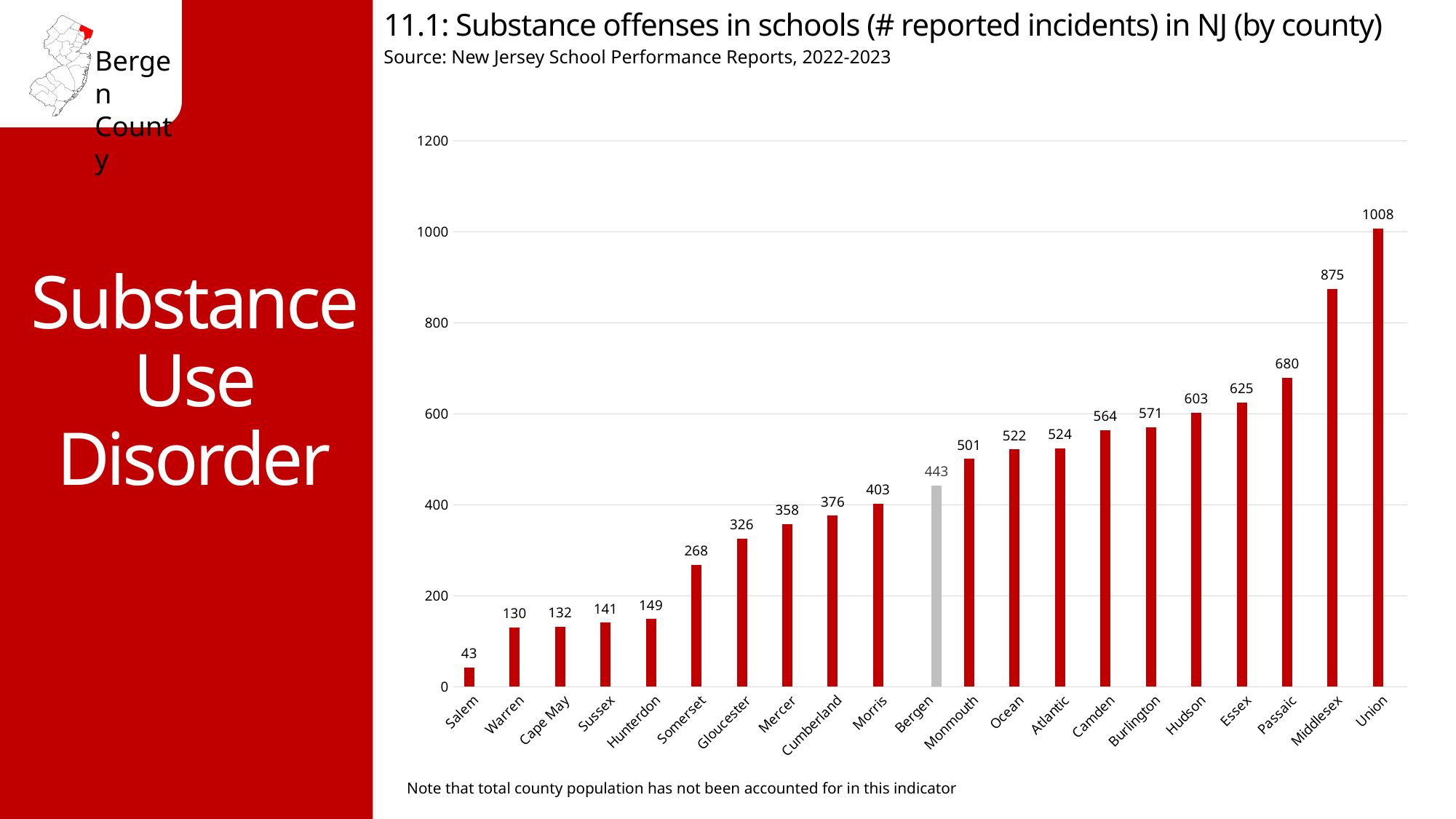
What kind of chart is shown on the slide? bar chart How many counties are shown on the chart? 21 Which bar is coloured grey instead of red? Bergen Which has more reported incidents, Camden or Morris? Camden What is the value shown for Middlesex? 875 What is the difference between the values for Bergen and Monmouth? 58 Do the values rise or fall moving from left to right along the x axis? rise What is the number of reported substance offense incidents in schools for Bergen County? 443 Which county has the lowest number of reported incidents? Salem Which county has the highest number of reported incidents? Union What is the difference between the values for Union and Middlesex? 133 Is the value for Essex greater or less than 600? greater